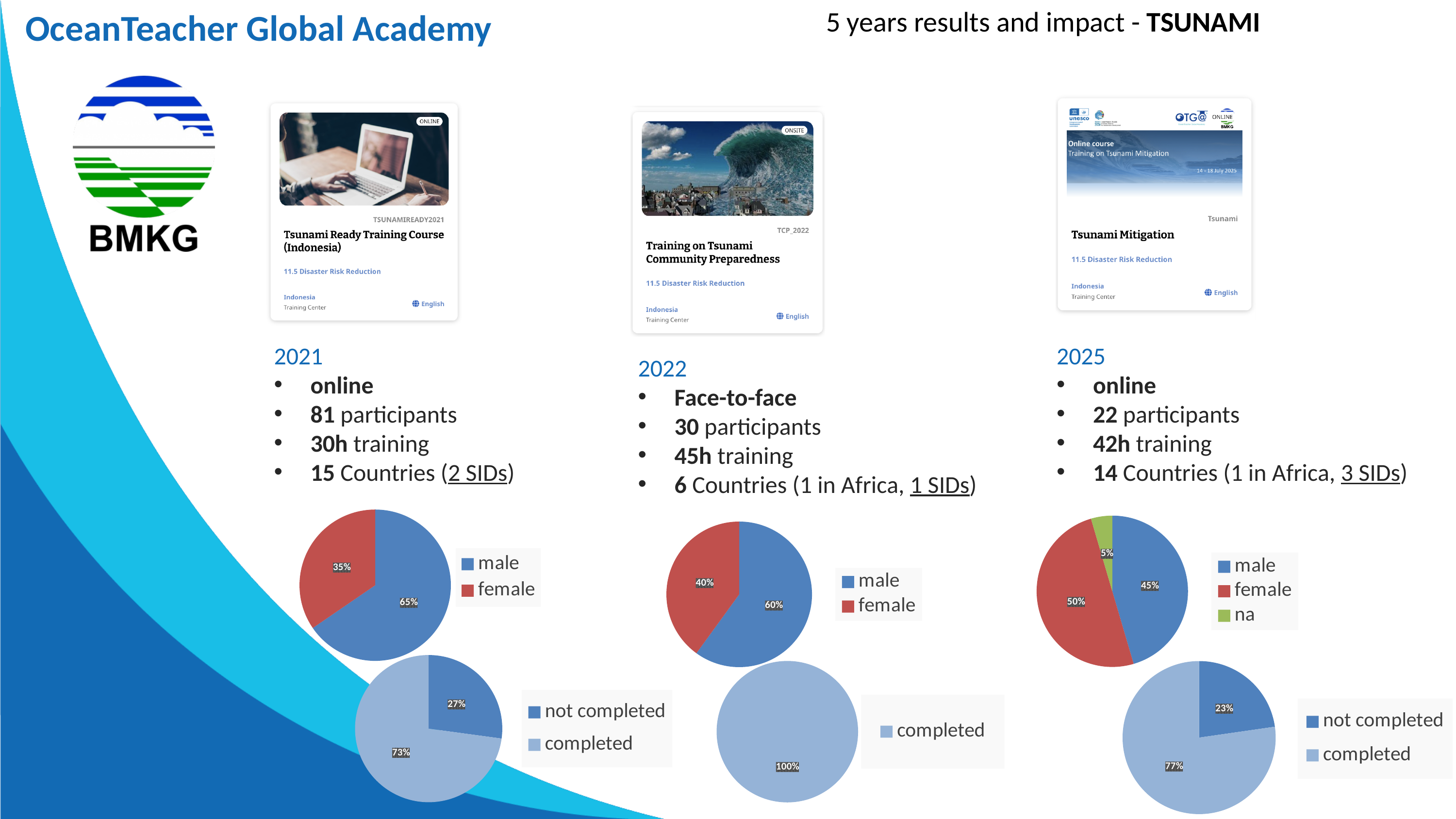
In the 2022 gender pie chart (middle column, upper pie), what share is female? 40% In the 2025 gender pie chart (right column, upper pie), what share is labelled na? 5% In the 2021 gender pie chart (left column, upper pie), what share is female? 35% In the 2021 completion pie chart (left column, lower pie), what share is not completed? 27% In the 2021 gender pie chart (left column, upper pie), what is the difference between the male and female shares? 30% In the 2022 completion pie chart (middle column, lower pie), what share is completed? 100% In the 2025 gender pie chart (right column, upper pie), which category has the smallest share? na In the 2025 gender pie chart (right column, upper pie), which category has the largest share? female How many entries does the legend of the 2025 gender pie chart (right column, upper pie) list? 3 In the 2025 completion pie chart (right column, lower pie), what share is completed? 77% In the 2021 gender pie chart (left column, upper pie), what share is male? 65% What type of chart is used to show the gender split for 2022 (middle column, upper chart)? pie chart